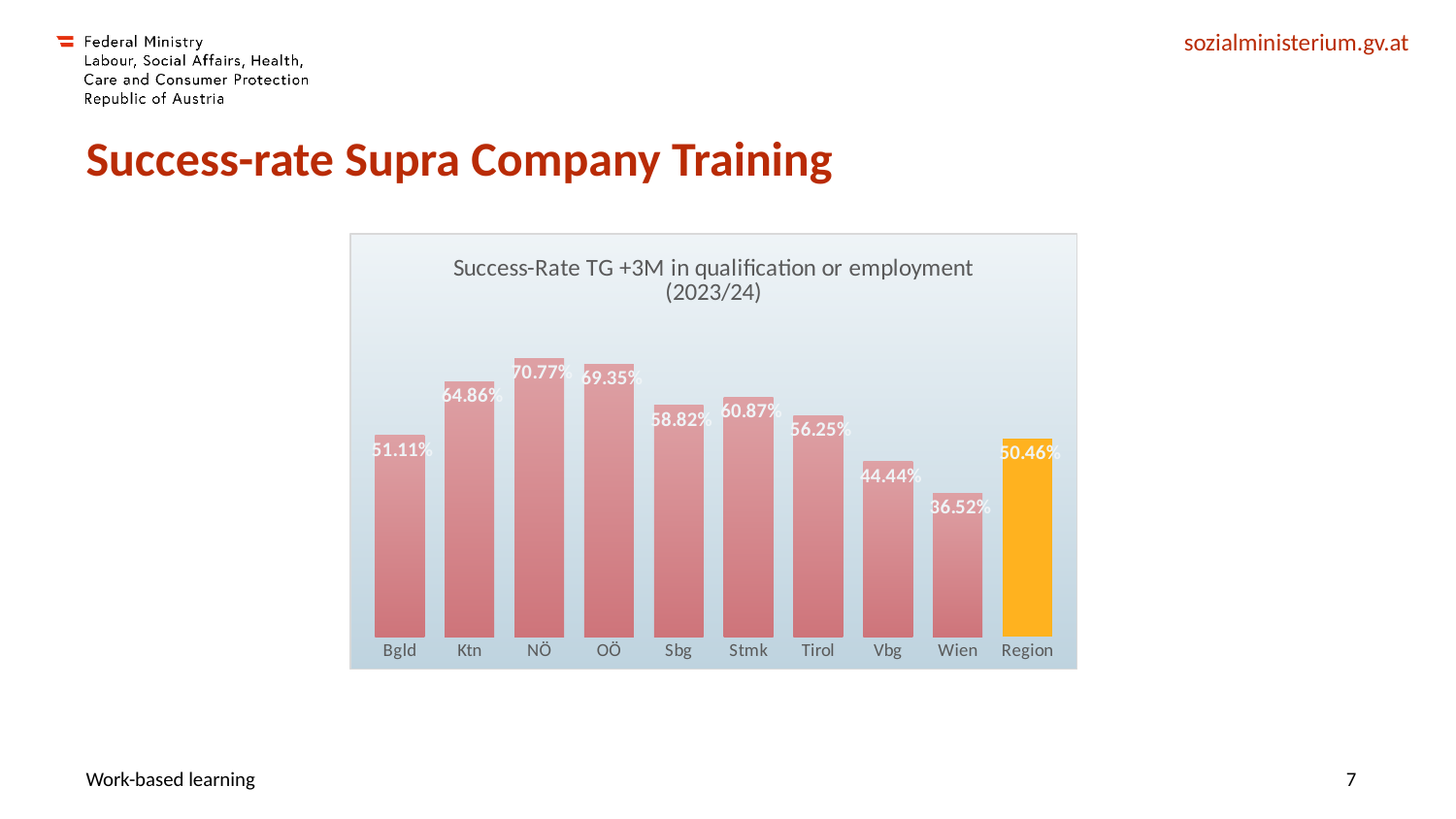
What is the success rate for Wien? 36.52% Which category has the lowest success rate? Wien What is the success rate for Region? 50.46% What is the difference between the success rates of Ktn and Bgld? 13.75% Which bar is coloured differently (orange) from the others? Region What is the success rate for NÖ? 70.77% Which has a higher success rate, Stmk or Sbg? Stmk How many categories are shown on the x axis? 10 Which category has the highest success rate? NÖ What kind of chart is shown on the slide? Bar chart Which has a higher success rate, Tirol or Vbg? Tirol What is the title of the chart? Success-Rate TG +3M in qualification or employment (2023/24)